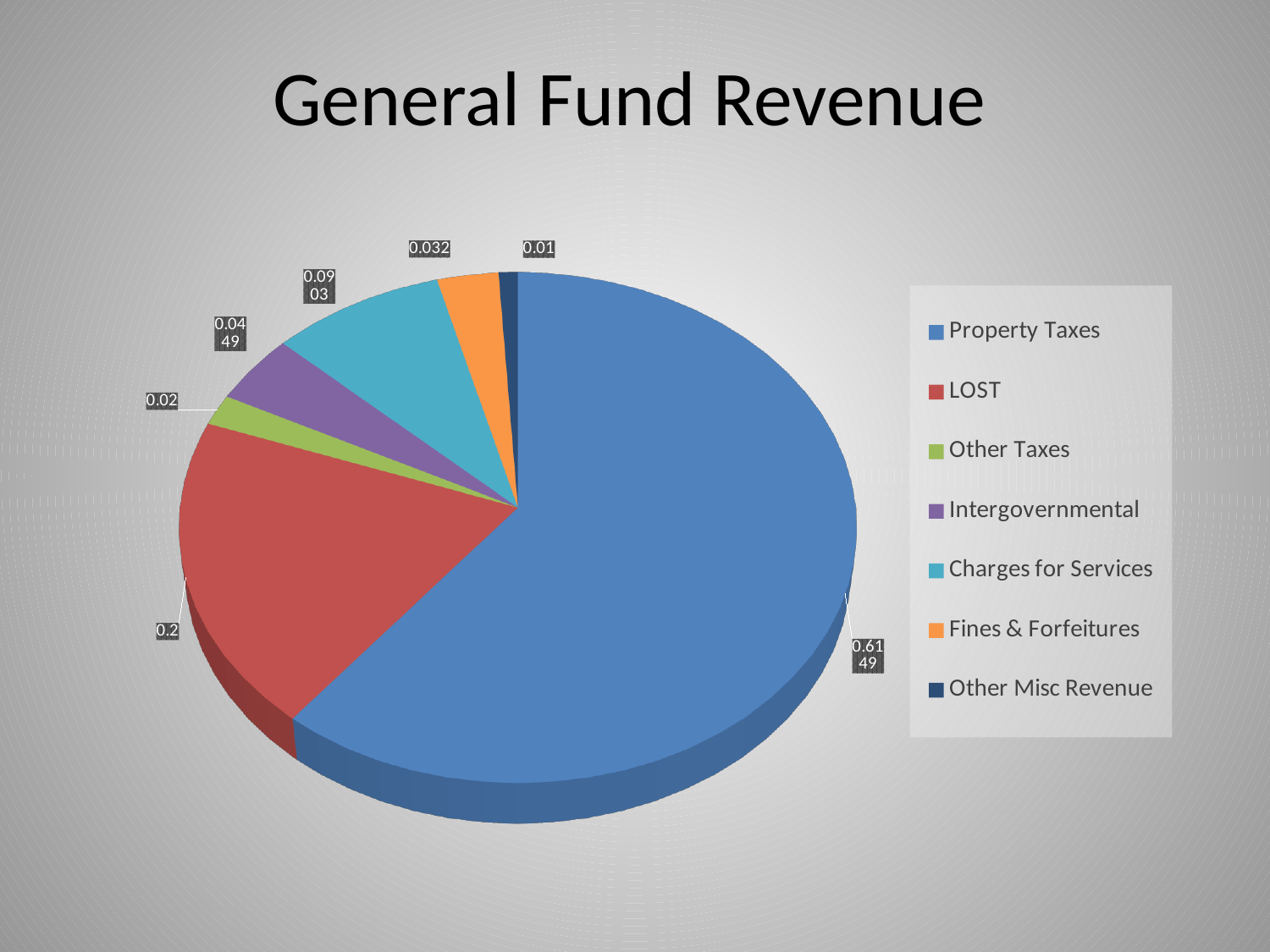
What is the value shown for LOST? 0.2 How many categories does the pie chart have? 7 Which is larger, Charges for Services or Intergovernmental? Charges for Services What is the value shown for Charges for Services? 0.0903 What is the title of the chart? General Fund Revenue Which category has the smallest slice of the pie? Other Misc Revenue Which category has the largest slice of the pie? Property Taxes What kind of chart is shown on the slide? pie chart What is the value shown for Property Taxes? 0.6149 What is the value shown for Intergovernmental? 0.0449 What is the difference between the values for LOST and Other Taxes? 0.18 What is the value shown for Fines & Forfeitures? 0.032